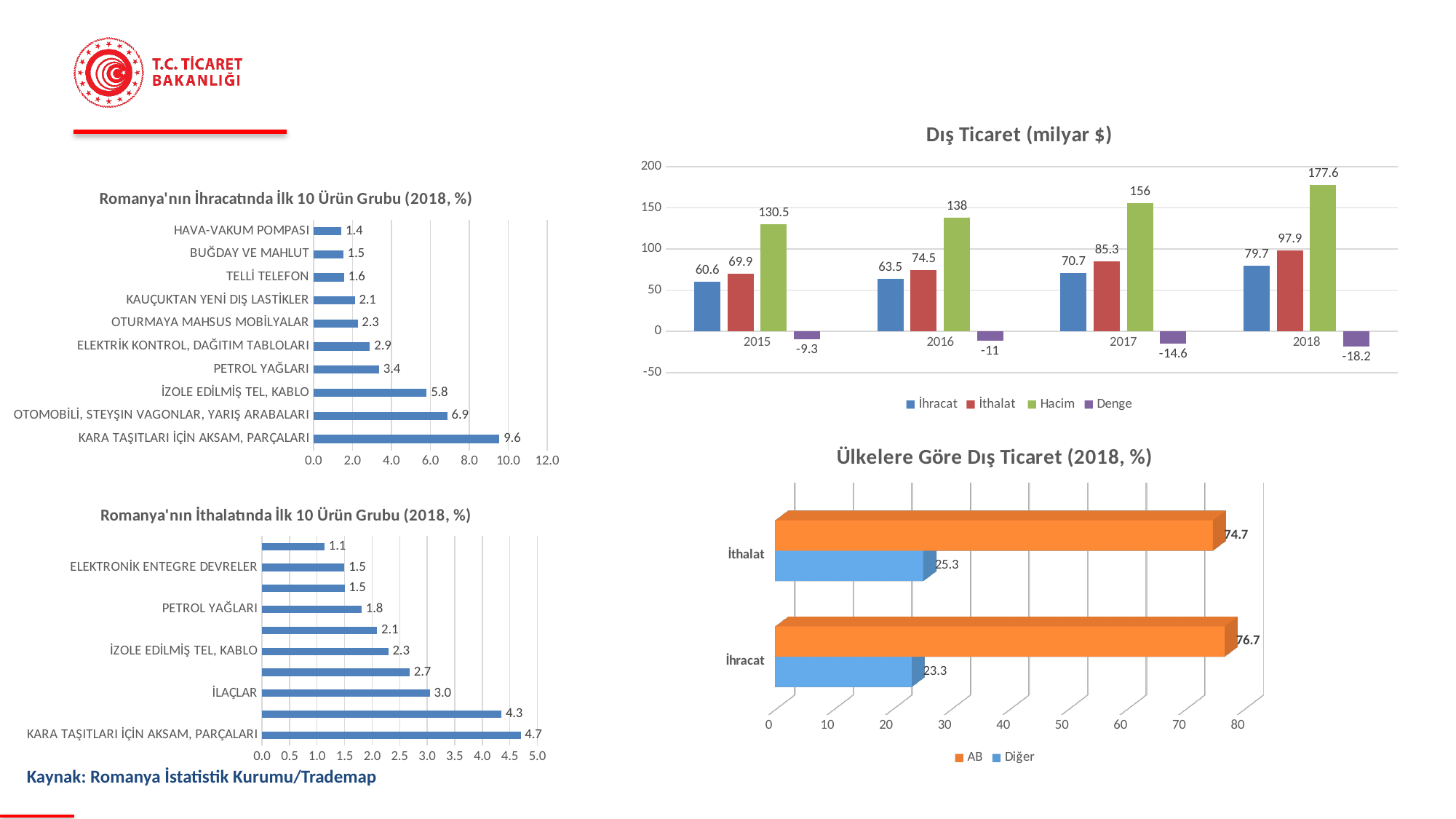
In the 'Romanya'nın İhracatında İlk 10 Ürün Grubu (2018, %)' chart, what is the value for PETROL YAĞLARI? 3.4 In the 'Romanya'nın İthalatında İlk 10 Ürün Grubu (2018, %)' chart, what is the value for İLAÇLAR? 3.0 In the 'Dış Ticaret (milyar $)' chart, what is the difference between İthalat and İhracat in 2018? 18.2 In the 'Dış Ticaret (milyar $)' chart, what is the İthalat value for 2016? 74.5 In the 'Romanya'nın İhracatında İlk 10 Ürün Grubu (2018, %)' chart, which product group has the highest value? KARA TAŞITLARI İÇİN AKSAM, PARÇALARI In the 'Dış Ticaret (milyar $)' chart, what is the Hacim value for 2018? 177.6 In the 'Romanya'nın İhracatında İlk 10 Ürün Grubu (2018, %)' chart, which product group has the lowest value? HAVA-VAKUM POMPASI In the 'Dış Ticaret (milyar $)' chart, how many series does the legend list? 4 In the 'Ülkelere Göre Dış Ticaret (2018, %)' chart, what is the AB share of İhracat? 76.7 In the 'Romanya'nın İthalatında İlk 10 Ürün Grubu (2018, %)' chart, how many bars are plotted? 10 In the 'Ülkelere Göre Dış Ticaret (2018, %)' chart, which is larger for İthalat: AB or Diğer? AB In the 'Dış Ticaret (milyar $)' chart, does the Hacim value rise or fall from 2015 to 2018? rise